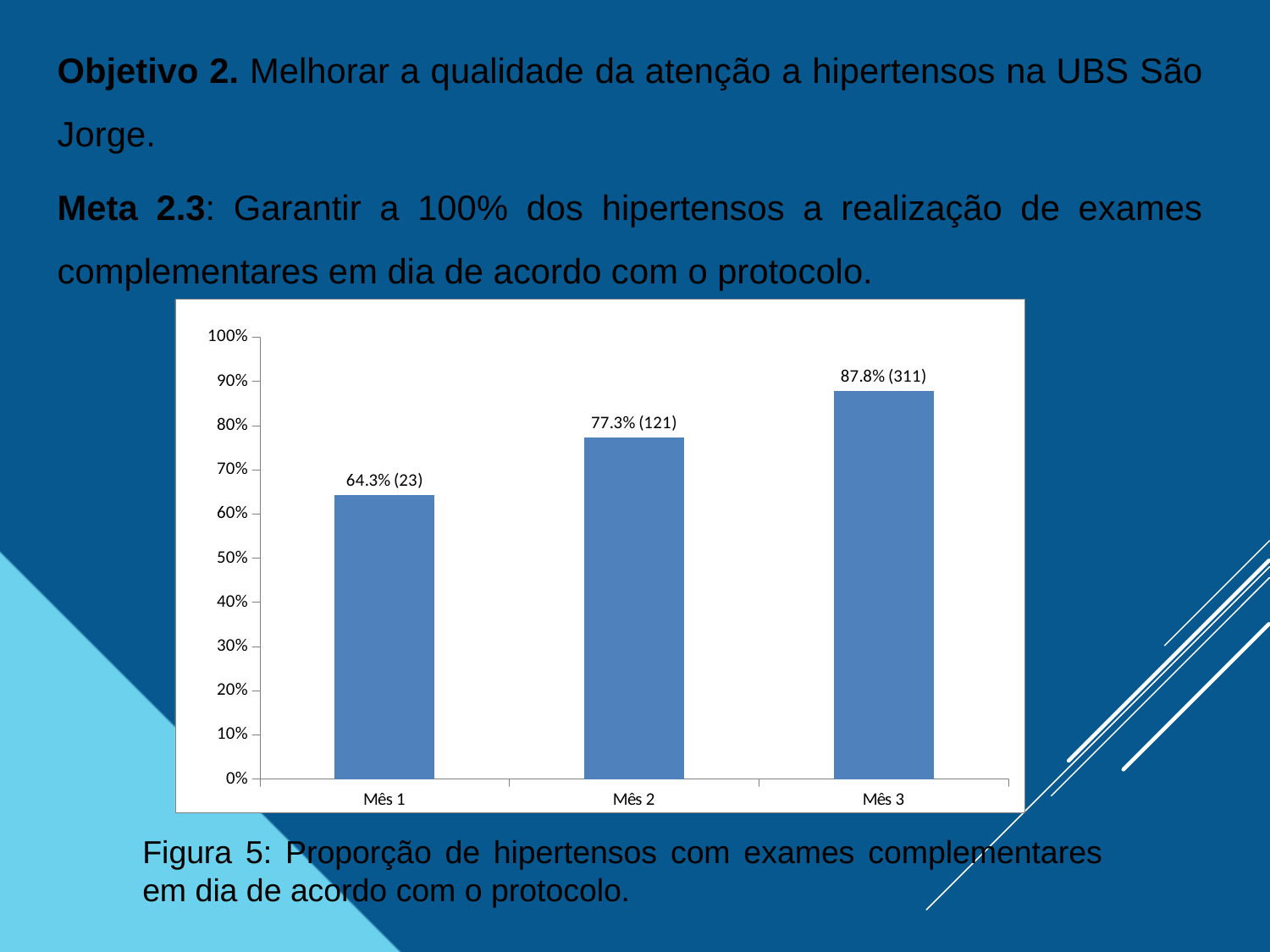
What percentage is shown for Mês 2? 77.3% What is the maximum value shown on the y axis? 100% What is the data label shown for Mês 1? 64.3% (23) Which is larger, the value for Mês 2 or the value for Mês 1? Mês 2 What is the difference in percentage points between Mês 3 and Mês 1? 23.5 How many months are shown on the x axis? 3 What is the count shown in parentheses for Mês 3? 311 Which month has the lowest value? Mês 1 Do the values rise or fall from Mês 1 to Mês 3? rise Which month has the highest value? Mês 3 What kind of chart is shown? bar chart Is the value for Mês 2 greater or less than 80%? less